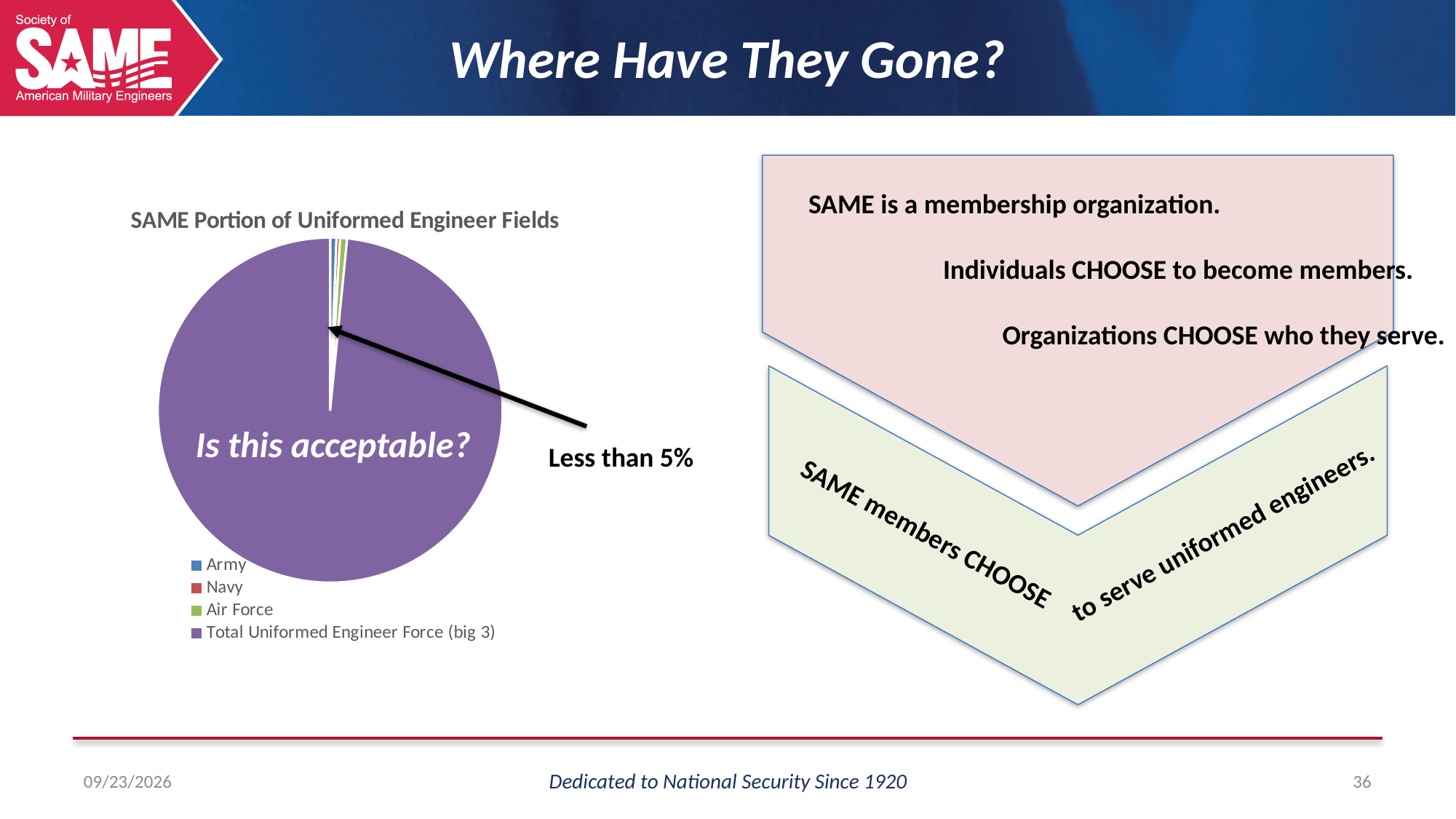
Which is larger in the pie chart: the slice for Air Force or the slice for Total Uniformed Engineer Force (big 3)? Total Uniformed Engineer Force (big 3) What kind of chart is shown on the slide? Pie chart How many categories does the pie chart's legend list? 4 According to the annotation pointing at the small slices of the pie chart, what share do they represent? Less than 5% Which is larger in the pie chart: the slice for Army or the slice for Total Uniformed Engineer Force (big 3)? Total Uniformed Engineer Force (big 3) What is the title of the pie chart? SAME Portion of Uniformed Engineer Fields Which category has the largest slice of the pie chart? Total Uniformed Engineer Force (big 3)